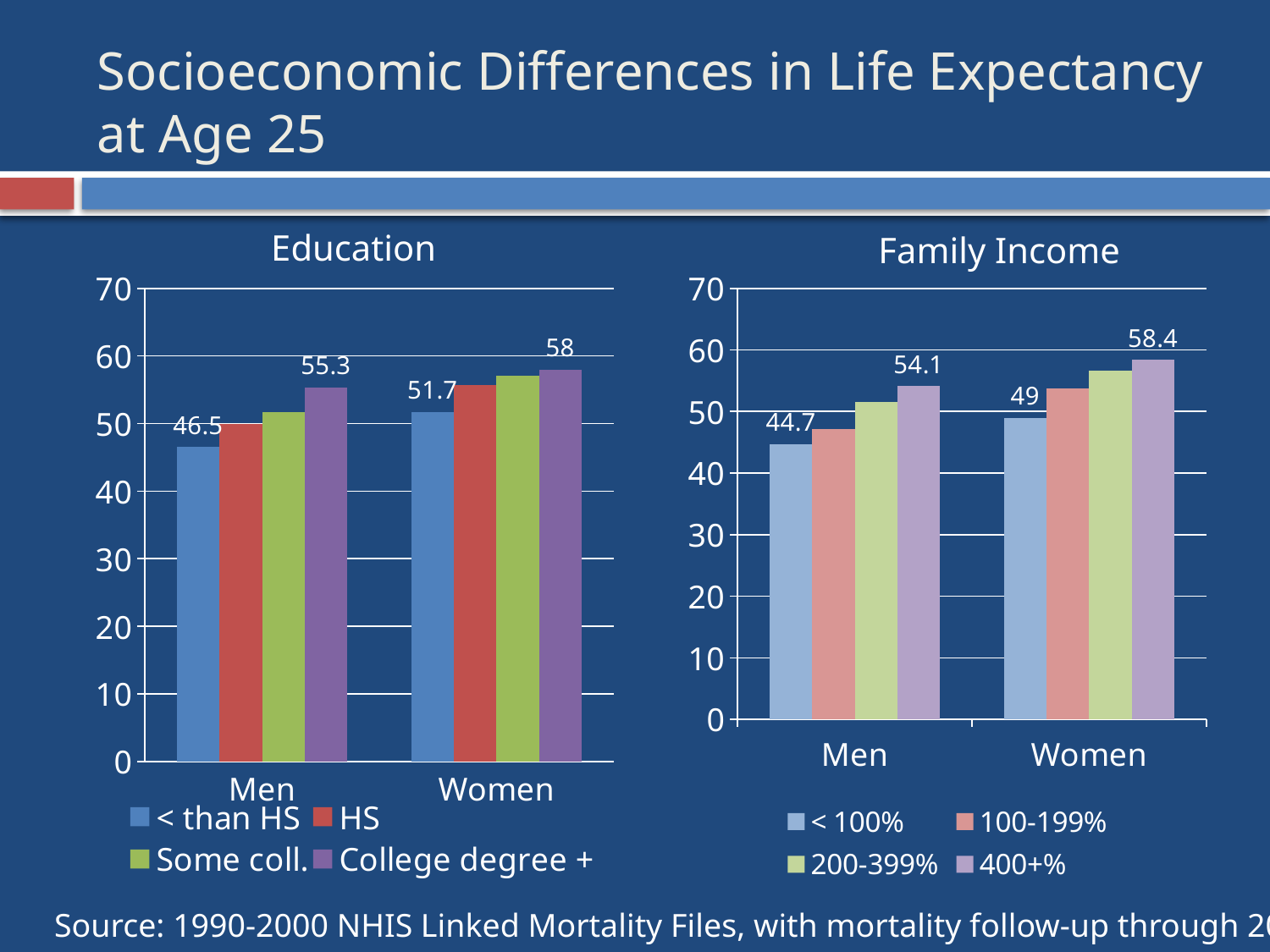
In the Family Income chart, is the value for men in the 100-199% group greater or less than 50? less In the Education chart, what is the difference between the College degree + value and the < than HS value for men? 8.8 In the Family Income chart, which income group has the highest value for men? 400+% In the Education chart, is the value for women with some college greater or less than 50? greater How many series does the legend of the Family Income chart list? 4 In the Education chart, which is larger for women: the < than HS value or the College degree + value? College degree + In the Family Income chart, what is the value for women in the 400+% income group? 58.4 In the Family Income chart, what is the value for men in the < 100% income group? 44.7 In the Education chart, what is the life expectancy at age 25 for men with less than a high school education? 46.5 In the Family Income chart, what is the difference between the 400+% value and the < 100% value for women? 9.4 In the Education chart, what is the value for women with a college degree or more? 58 What kind of chart is the Education chart? Bar chart